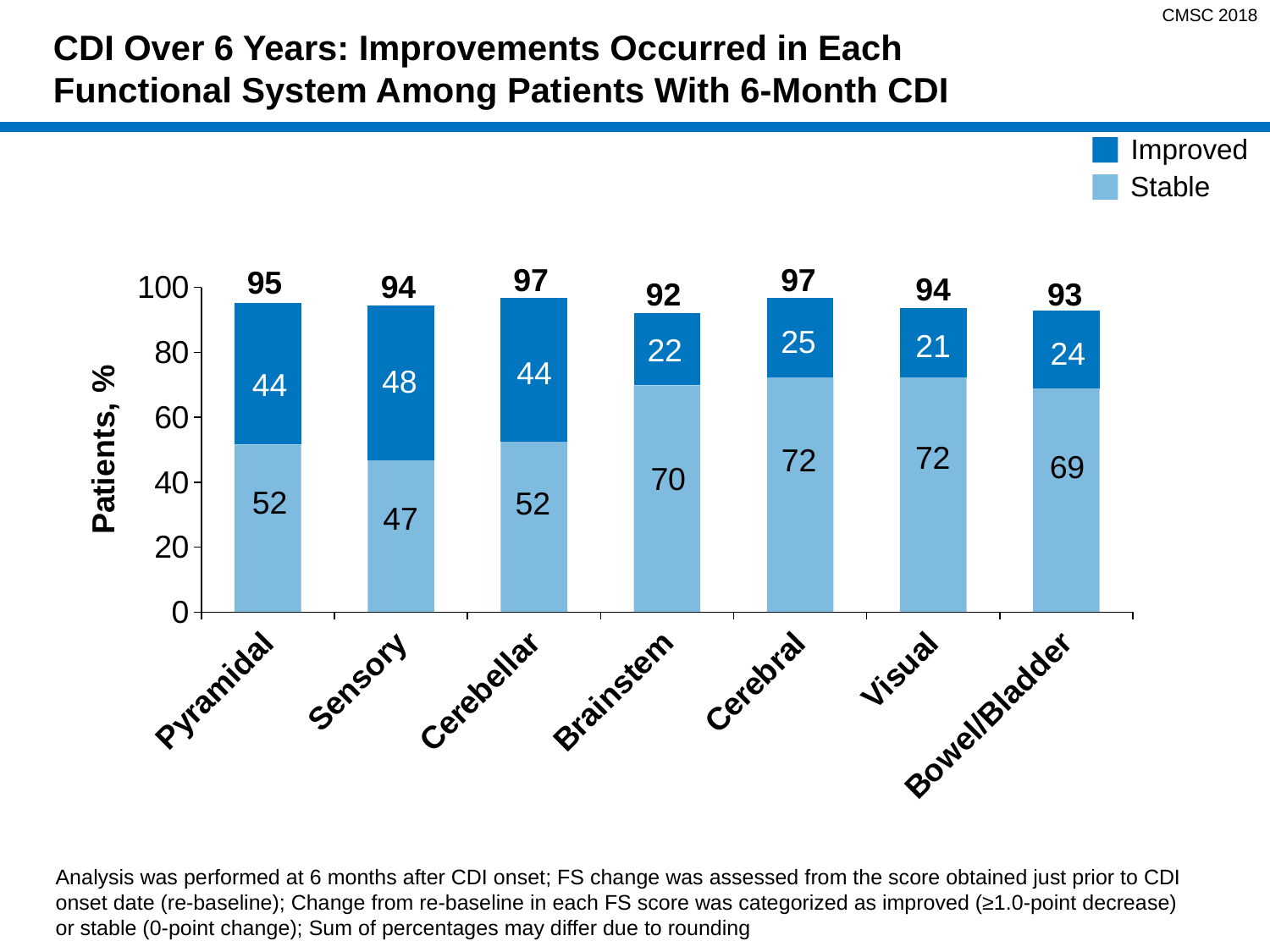
How many functional systems (categories) are shown on the x axis? 7 Which is larger: the Stable percentage for Cerebral or the Stable percentage for Pyramidal? Cerebral Which functional system has the lowest Stable percentage? Sensory Which functional system has the lowest Improved percentage? Visual What is the total percentage printed above the Cerebellar bar? 97 What percentage of patients were Stable in the Brainstem functional system? 70 What is the label of the y axis? Patients, % Which functional system has the highest Improved percentage? Sensory What kind of chart is shown on the slide? Stacked bar chart What is the difference between the Stable and Improved percentages for Brainstem? 48 What percentage of patients Improved in the Sensory functional system? 48 How many series does the legend list? 2